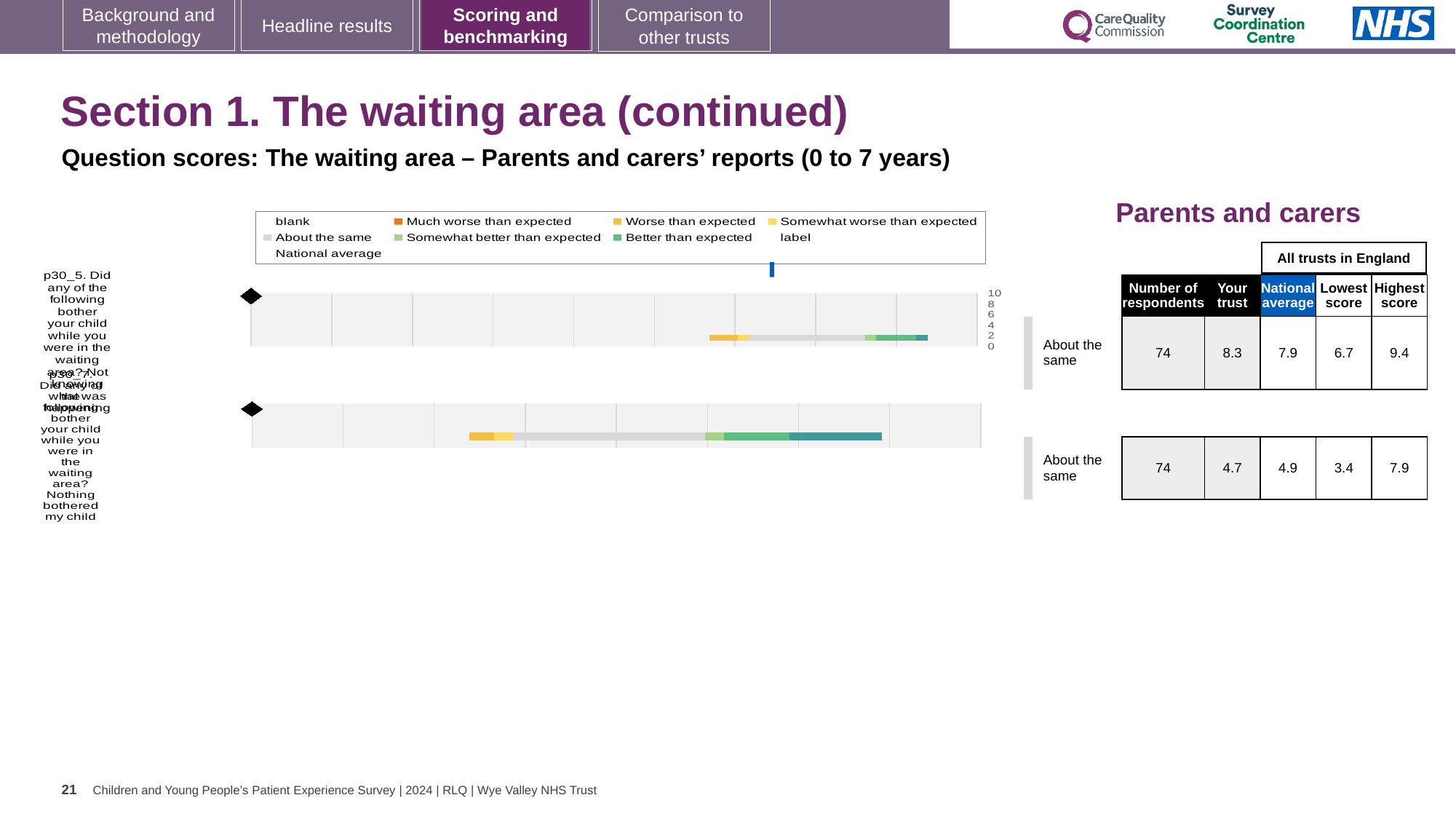
What kind of chart is shown on the slide? bar chart What is the lowest score among all trusts in England for the bottom row (question p30_7)? 3.4 In the table, what is the 'Your trust' score for the bottom row (question p30_7, Nothing bothered my child)? 4.7 For question p30_5, what is the difference between the highest score and the lowest score among all trusts in England? 2.7 In the table, what is the national average for the top row (question p30_5)? 7.9 For question p30_5, which is larger: the 'Your trust' score or the national average? Your trust How many questions (bars) are plotted in the chart? 2 How many respondents are shown for question p30_5 in the table? 74 What is the highest score among all trusts in England for the top row (question p30_5)? 9.4 What benchmark category is shown next to both bars in the chart? About the same In the table, what is the 'Your trust' score for the top row (question p30_5, Not knowing what was happening)? 8.3 What colour does the legend use for 'Much worse than expected'? orange